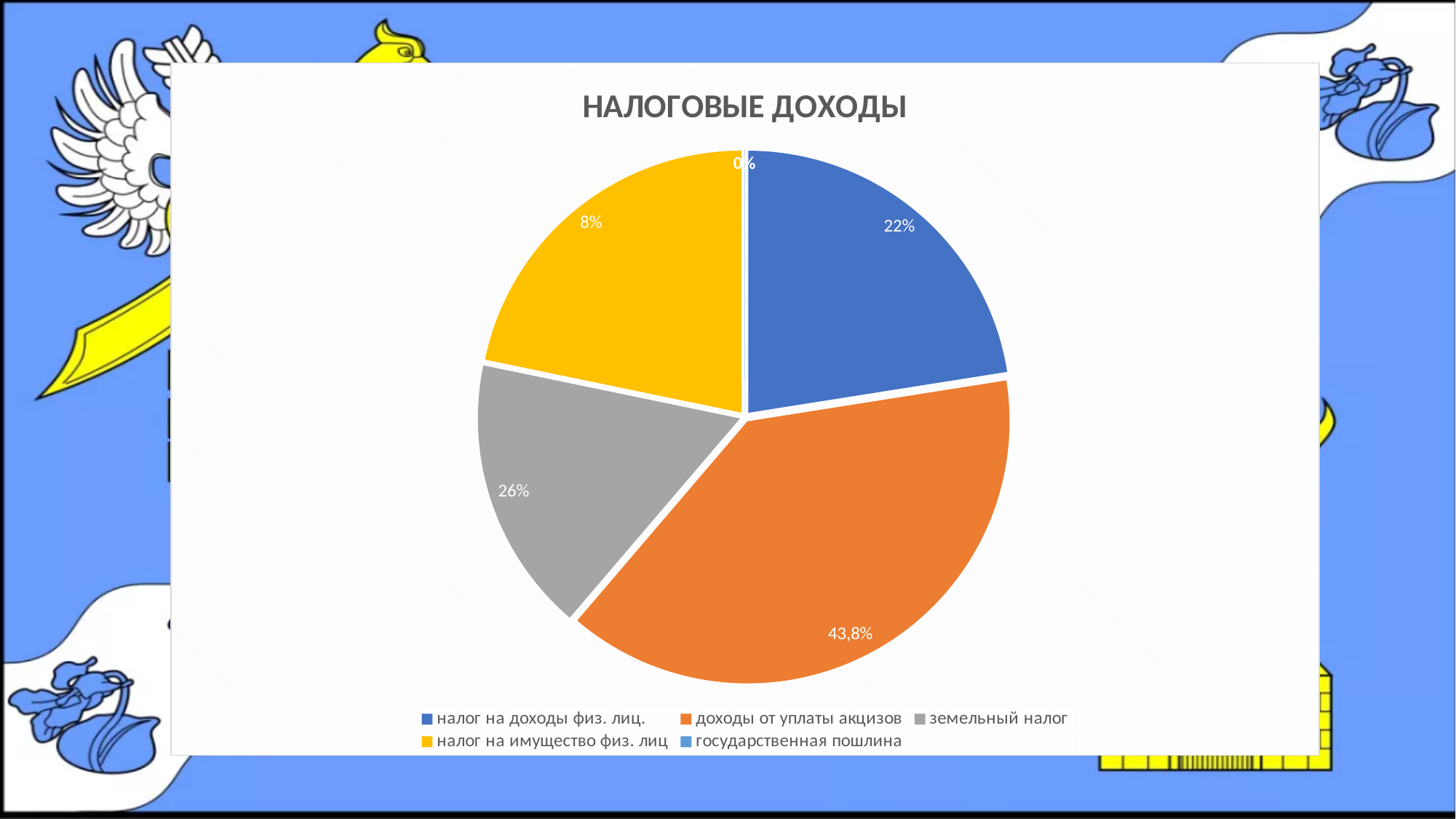
How many categories does the legend list? 5 Which category has the largest share of the pie? доходы от уплаты акцизов What share of the pie is labelled for земельный налог? 26% Which category has the smallest share of the pie? государственная пошлина What share of the pie is labelled for доходы от уплаты акцизов? 43,8% What share of the pie is labelled for налог на доходы физ. лиц.? 22% What share of the pie is labelled for налог на имущество физ. лиц? 8% What share of the pie is labelled for государственная пошлина? 0% What is the title of the chart? НАЛОГОВЫЕ ДОХОДЫ What type of chart is shown on the slide? pie chart